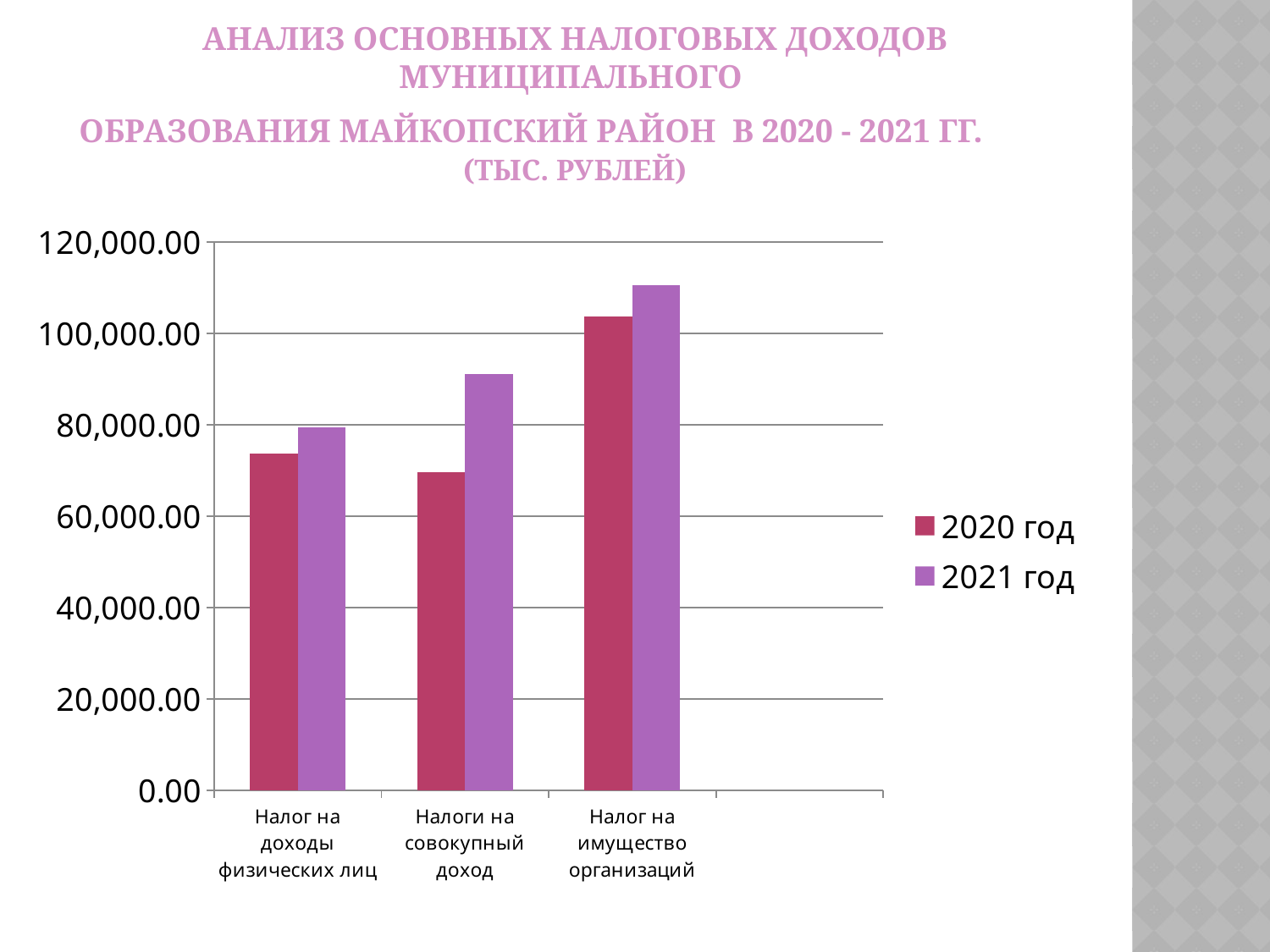
Which category has the highest value for 2021 год? Налог на имущество организаций Is the value for Налоги на совокупный доход in 2020 год greater or less than 80,000.00? less What kind of chart is shown on the slide? bar chart How many categories are shown on the x axis? 3 Which series is shown in purple in the legend? 2021 год Is the value for Налоги на совокупный доход in 2021 год greater or less than 100,000.00? less For Налоги на совокупный доход, which series is larger: 2020 год or 2021 год? 2021 год Is the value for Налог на имущество организаций in 2021 год greater or less than 100,000.00? greater Which category has the lowest value for 2020 год? Налоги на совокупный доход How many series does the legend list? 2 What unit of measurement is stated in the chart title? тыс. рублей